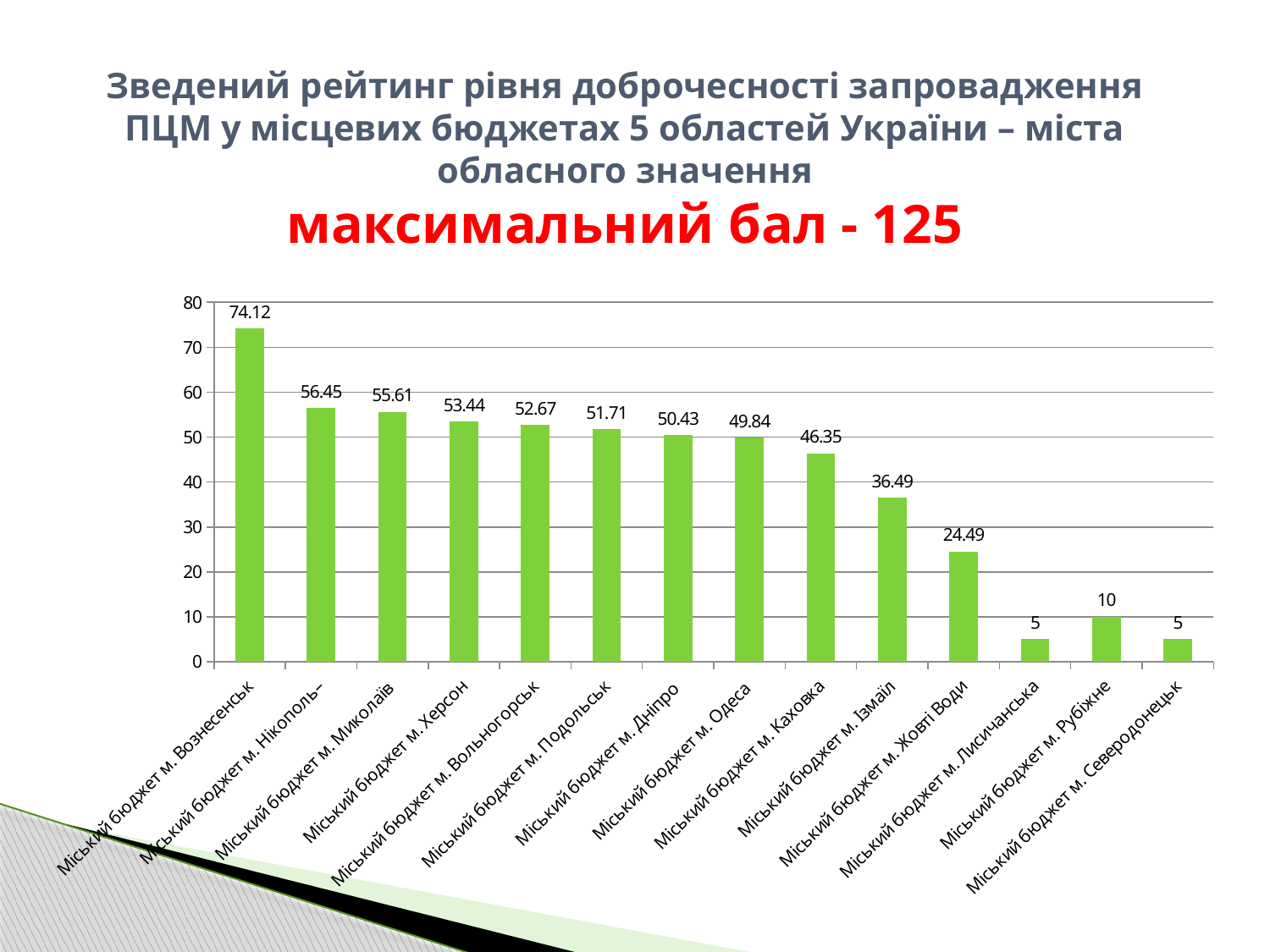
Which city budget has the highest value in the chart? Міський бюджет м. Вознесенськ What is the value for Міський бюджет м. Вознесенськ? 74.12 What is the value for Міський бюджет м. Рубіжне? 10 What is the lowest value shown in the chart? 5 Which is larger, the value for Міський бюджет м. Каховка or Міський бюджет м. Ізмаїл? Міський бюджет м. Каховка What is the difference between the values for Міський бюджет м. Вознесенськ and Міський бюджет м. Нікополь? 17.67 How many city budgets (bars) are shown in the chart? 14 What kind of chart is shown on the slide? bar chart What is the value for Міський бюджет м. Жовті Води? 24.49 What is the difference between the values for Міський бюджет м. Ізмаїл and Міський бюджет м. Жовті Води? 12 What maximum score is stated in the slide title? 125 What is the value for Міський бюджет м. Херсон? 53.44